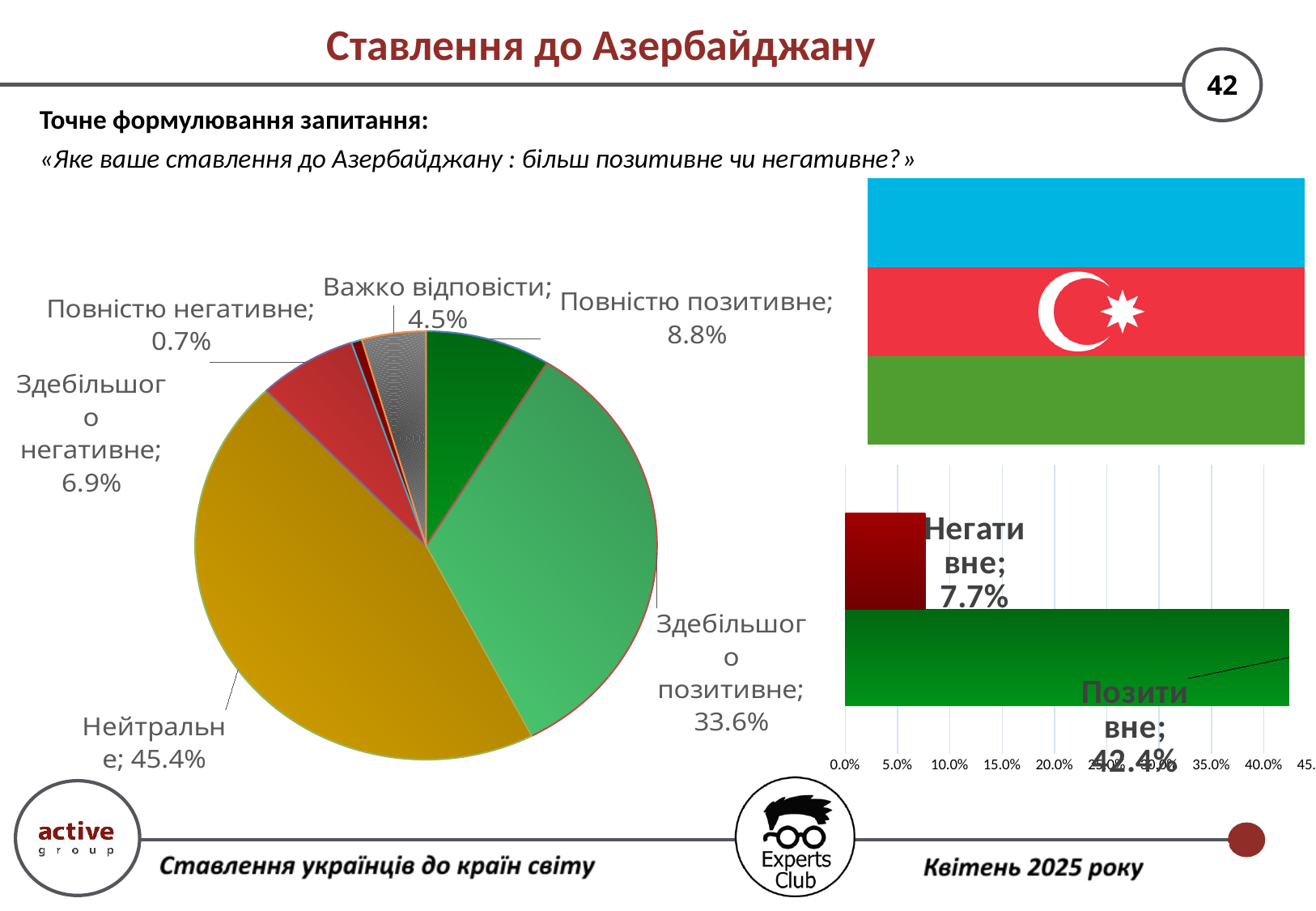
In the bar chart on the right, what is the value for «Позитивне»? 42.4% In the pie chart, how many slices (categories) are shown? 6 In the bar chart on the right, what is the value for «Негативне»? 7.7% What type of chart is shown on the right side of the slide below the flag? Bar chart In the pie chart, which is larger: «Здебільшого негативне» or «Важко відповісти»? Здебільшого негативне In the bar chart on the right, what is the difference between «Позитивне» and «Негативне»? 34.7% In the pie chart, what is the value for «Здебільшого позитивне»? 33.6% In the pie chart, what is the difference between «Здебільшого позитивне» and «Повністю позитивне»? 24.8% In the pie chart, which category has the largest slice? Нейтральне In the pie chart, which category has the smallest slice? Повністю негативне In the pie chart, what is the value for «Повністю негативне»? 0.7% In the pie chart, what share of respondents answered «Нейтральне»? 45.4%